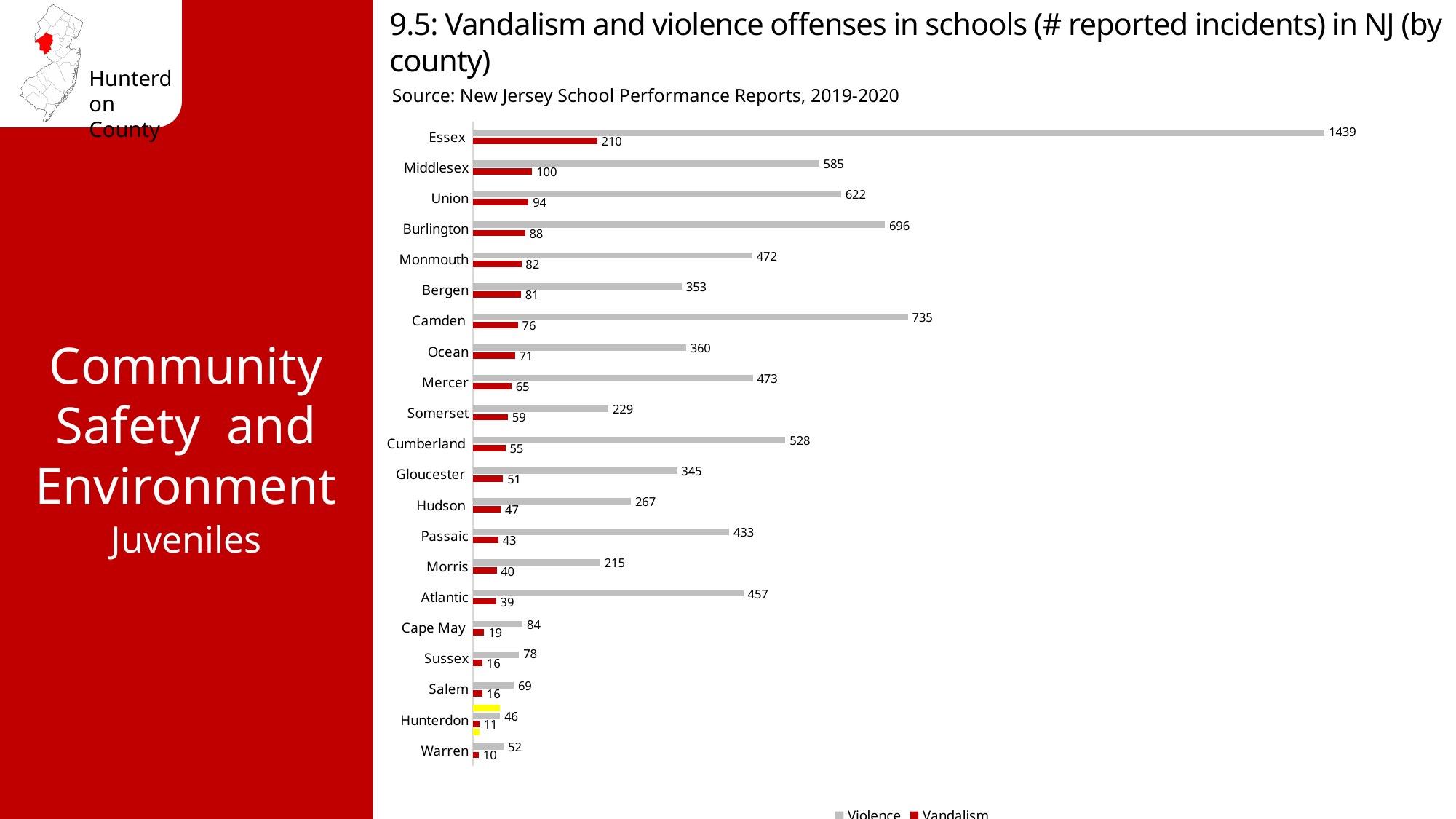
How many series does the legend list? 2 Which county has more reported violence incidents, Union or Burlington? Burlington What is the difference between the violence incidents in Essex and Middlesex? 854 What kind of chart is shown on the slide? Bar chart What is the number of reported vandalism incidents in schools for Hunterdon County? 11 How many counties are shown on the chart? 21 Which county has the lowest number of reported violence incidents? Hunterdon Which county has the highest number of reported vandalism incidents? Essex What is the total of violence and vandalism incidents for Warren County? 62 What is the number of reported violence incidents in schools for Camden County? 735 What is the number of reported violence incidents in schools for Essex County? 1439 Which colour represents the Vandalism series in the chart? Red